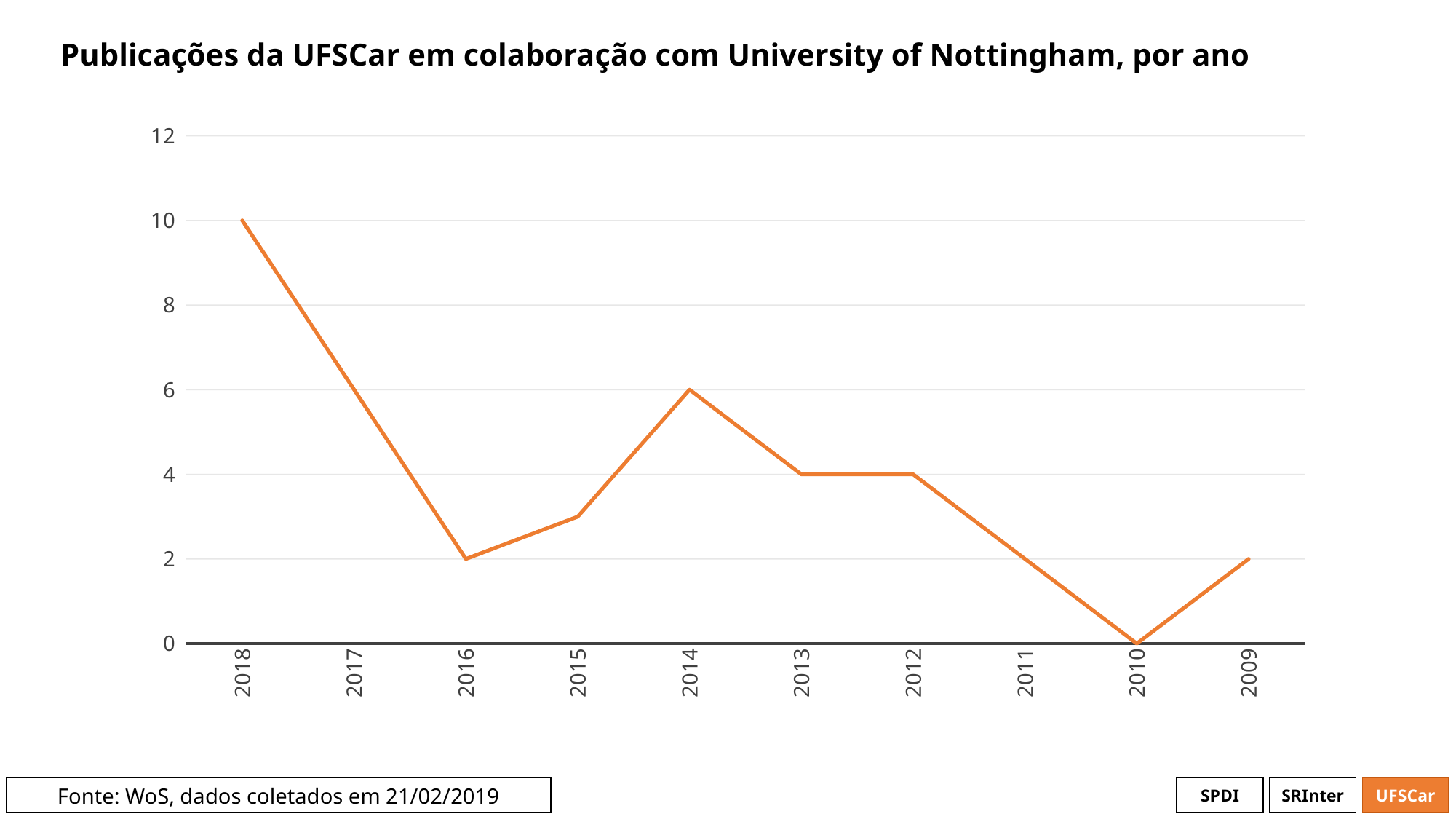
Which year has the lowest number of publications? 2010 What is the number of publications for 2014? 6 What is the difference between the number of publications in 2018 and in 2014? 4 How many years are shown on the x axis? 10 Which year has more publications, 2014 or 2012? 2014 What is the number of publications for 2016? 2 What kind of chart is shown on the slide? line chart Is the value for 2015 greater or less than 4? less What is the number of publications for 2018? 10 Is the value for 2017 greater or less than 4? greater Which year has the highest number of publications? 2018 What is the number of publications for 2010? 0